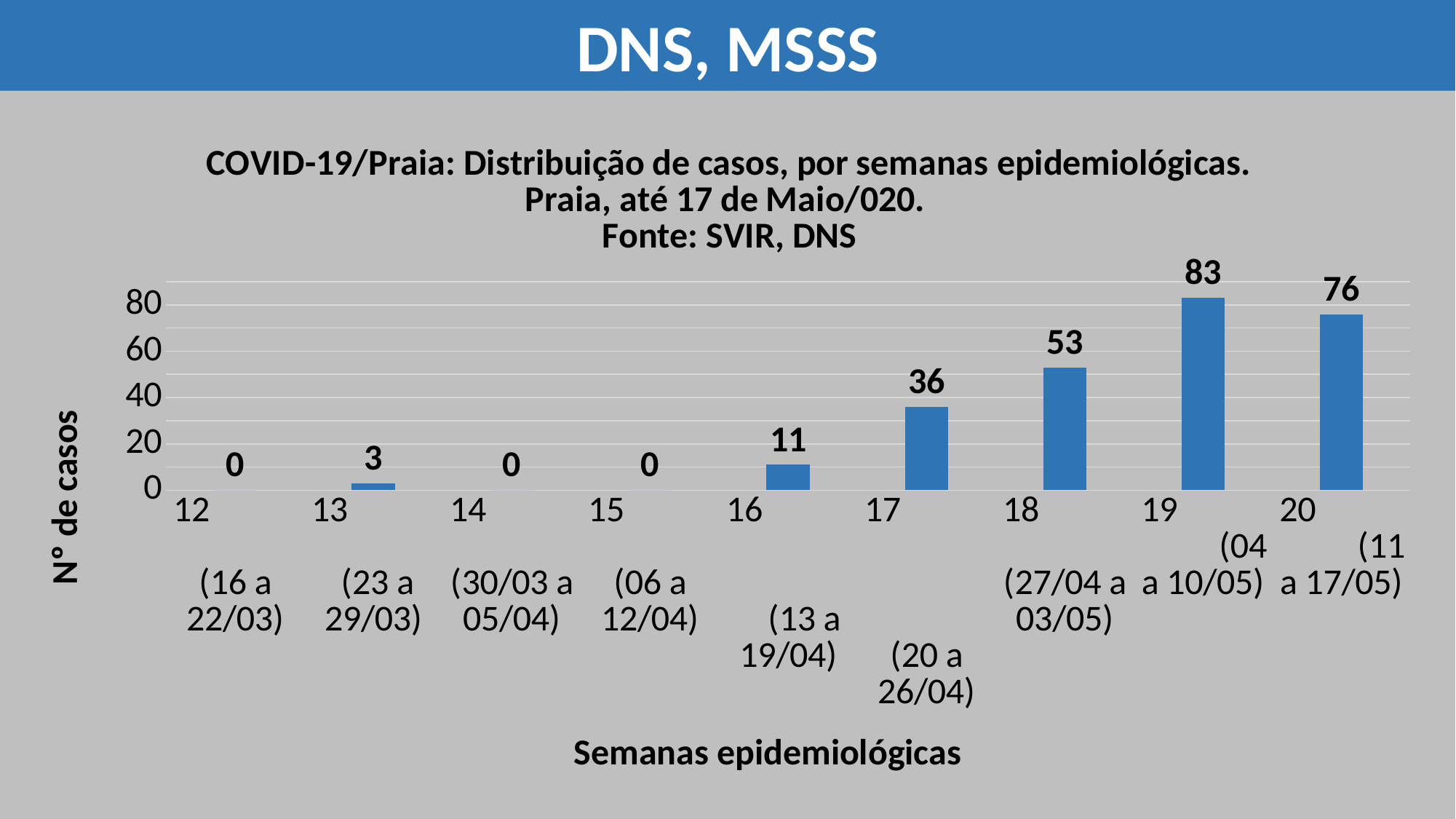
What is the difference in cases between week 18 and week 17? 17 How many cases are shown for epidemiological week 19? 83 Which epidemiological week has the highest number of cases? 19 Which has more cases, week 18 or week 20? Week 20 How many weeks have 0 cases? 3 What is the number of cases for epidemiological week 17? 36 What is the number of cases for epidemiological week 13? 3 What kind of chart is this? Bar chart How many epidemiological weeks are shown on the x axis? 9 What is the label of the y axis? N° de casos Do the number of cases generally rise or fall from week 14 to week 19? Rise What is the difference in cases between week 19 and week 20? 7